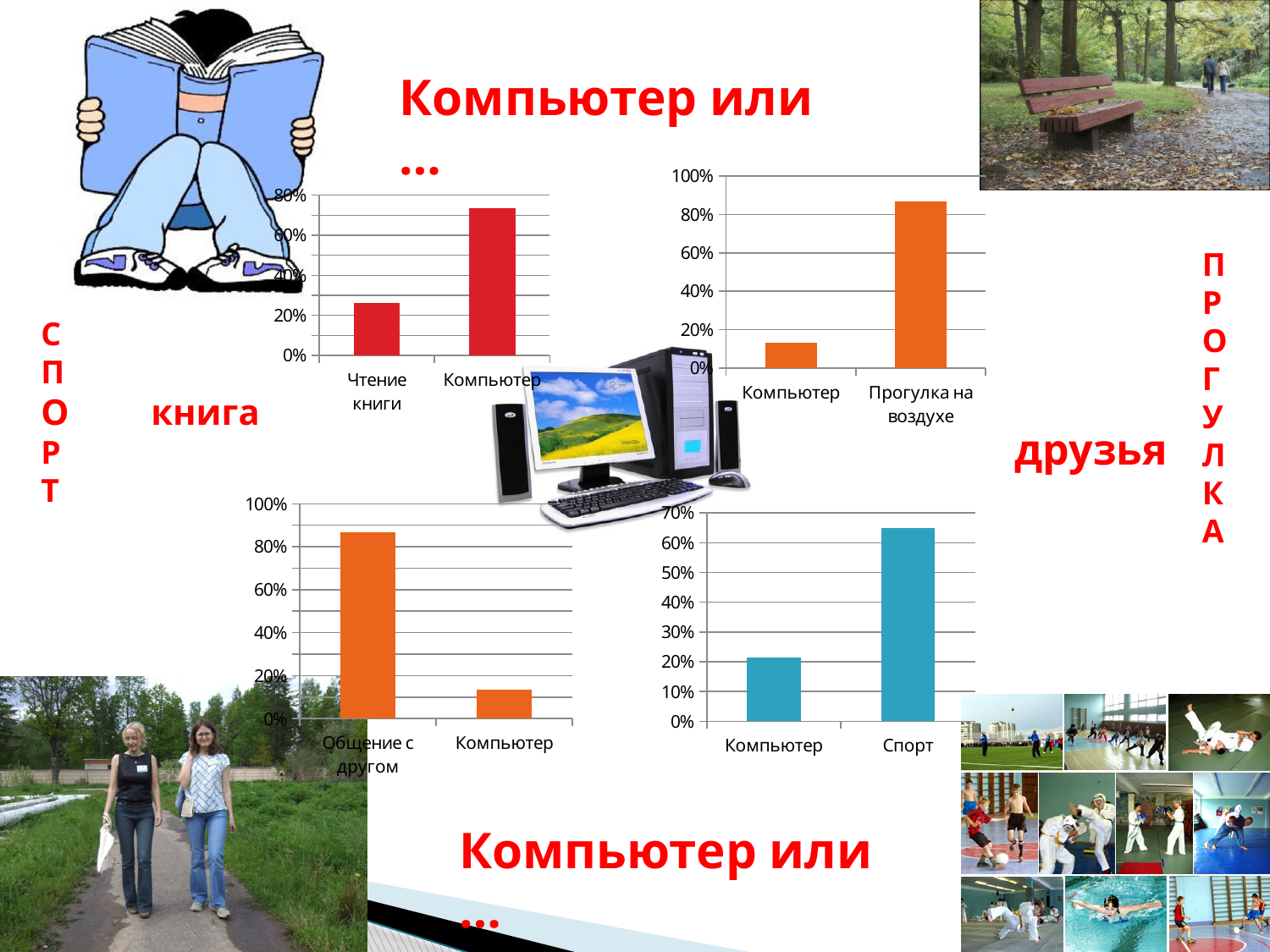
How many categories does the top-left chart show? 2 In the top-left chart, which category has the higher value? Компьютер In the bottom-left chart, is the value for Общение с другом greater or less than 80%? greater In the top-right chart, is the value for Прогулка на воздухе greater or less than 80%? greater In the top-right chart, which category has the lowest value? Компьютер In the top-left chart, is the value for Компьютер greater or less than 60%? greater In the bottom-right chart, which category has the highest value? Спорт In the bottom-left chart, which is larger: Общение с другом or Компьютер? Общение с другом What type of chart is the bottom-right chart? bar chart